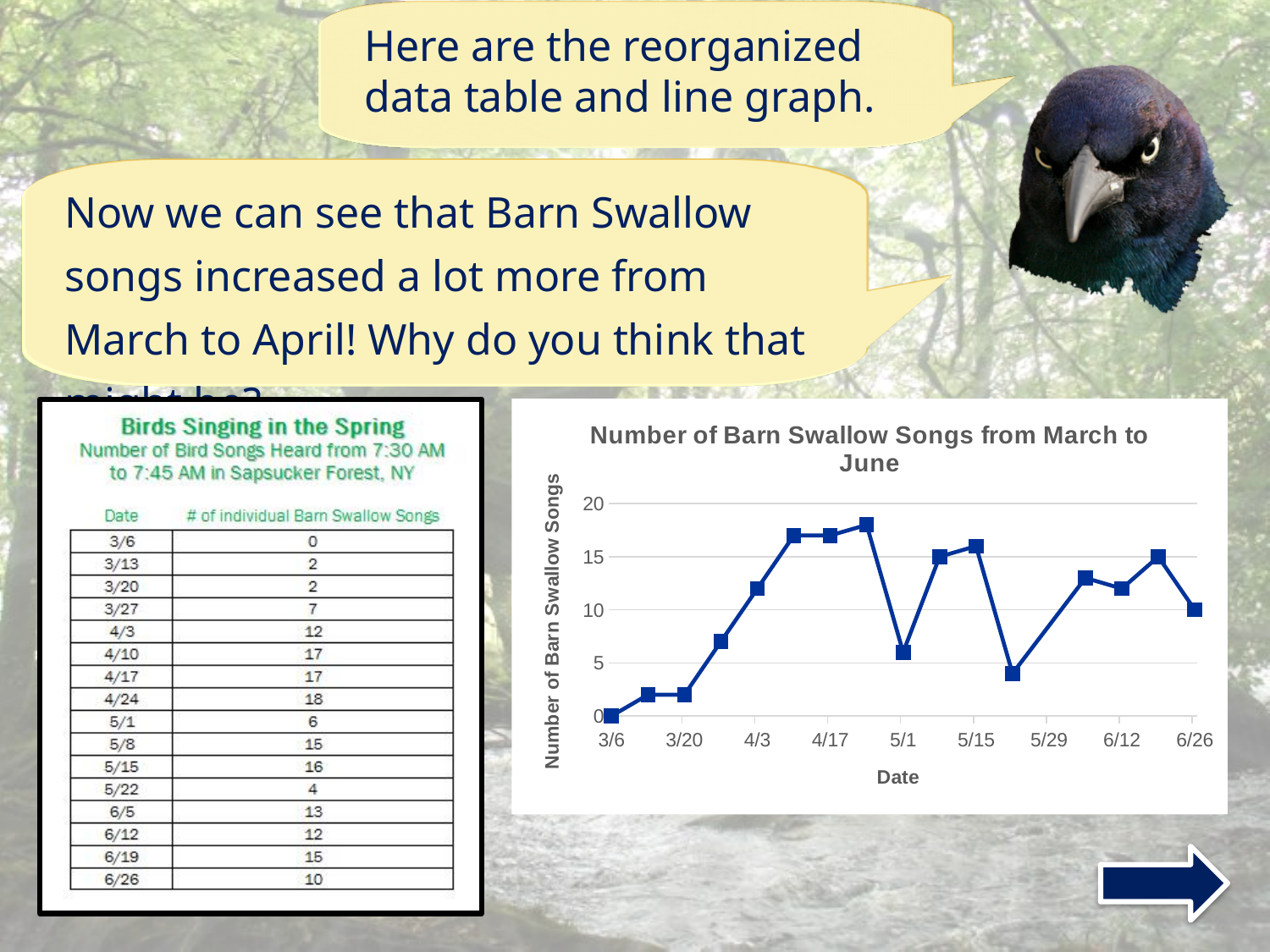
What is the number of Barn Swallow songs on 5/8? 15 Which date has more Barn Swallow songs, 4/3 or 5/22? 4/3 What is the number of Barn Swallow songs on 6/26? 10 On which date is the number of Barn Swallow songs lowest? 3/6 On which date is the number of Barn Swallow songs highest? 4/24 How many data points are plotted on the line chart? 16 What kind of chart is shown on the slide? line chart Is the number of Barn Swallow songs on 6/5 greater or less than 10? greater What is the title of the chart? Number of Barn Swallow Songs from March to June What is the label on the vertical axis of the chart? Number of Barn Swallow Songs Is the number of Barn Swallow songs on 5/1 greater or less than 10? less What is the number of Barn Swallow songs on 3/6? 0